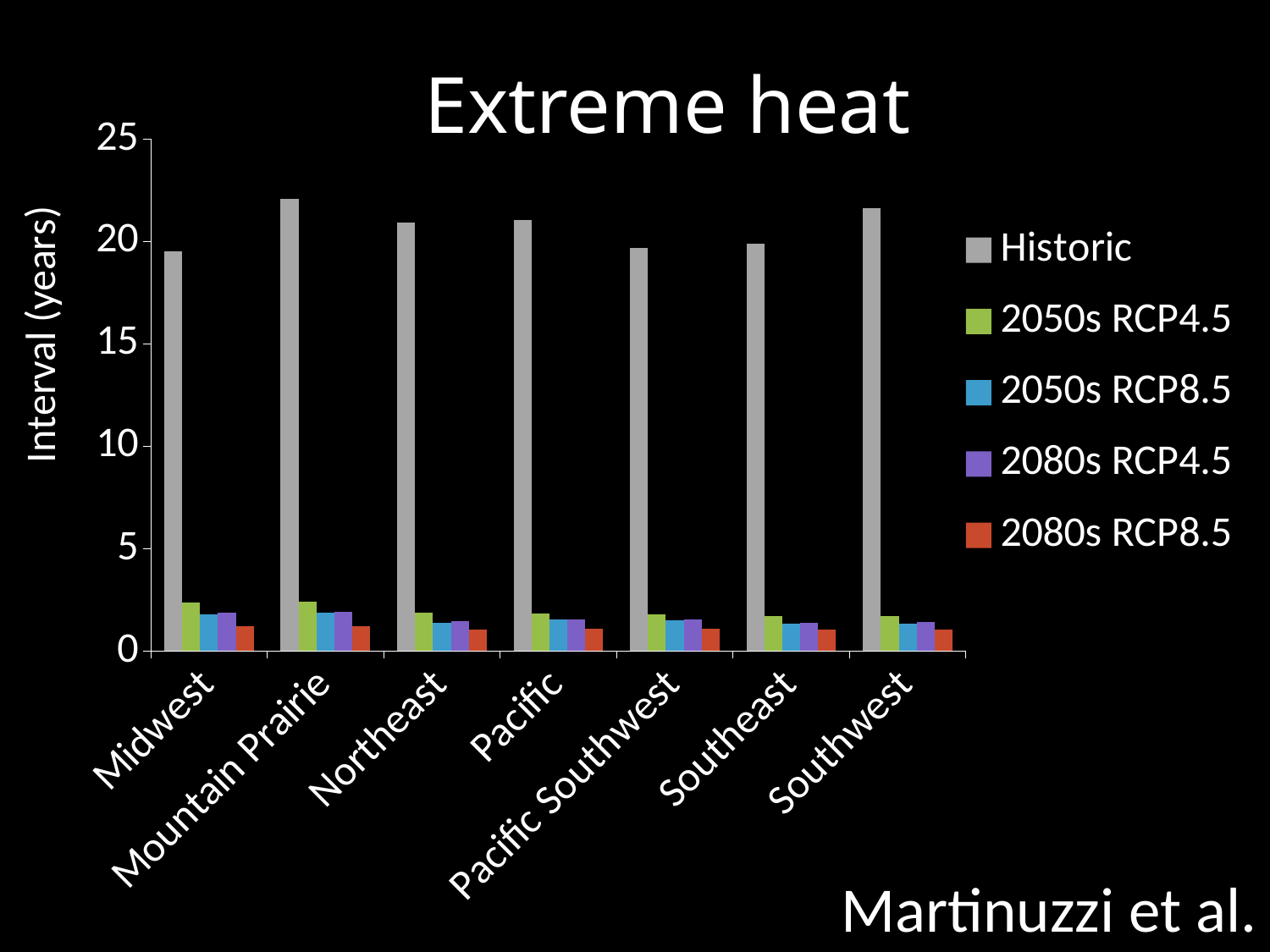
Is the Historic value for Southwest greater or less than 20? greater How many series does the legend list? 5 Which series has the highest value in every region? Historic What kind of chart is shown on the slide? bar chart Is the 2080s RCP8.5 value for Southwest greater or less than 5? less What is the label of the vertical axis? Interval (years) Which is larger for Northeast, the Historic value or the 2050s RCP4.5 value? Historic How many regions are shown along the x axis? 7 Is the Historic value for Mountain Prairie greater or less than 20? greater What is the title of the chart? Extreme heat Which region has the larger Historic value, Mountain Prairie or Midwest? Mountain Prairie